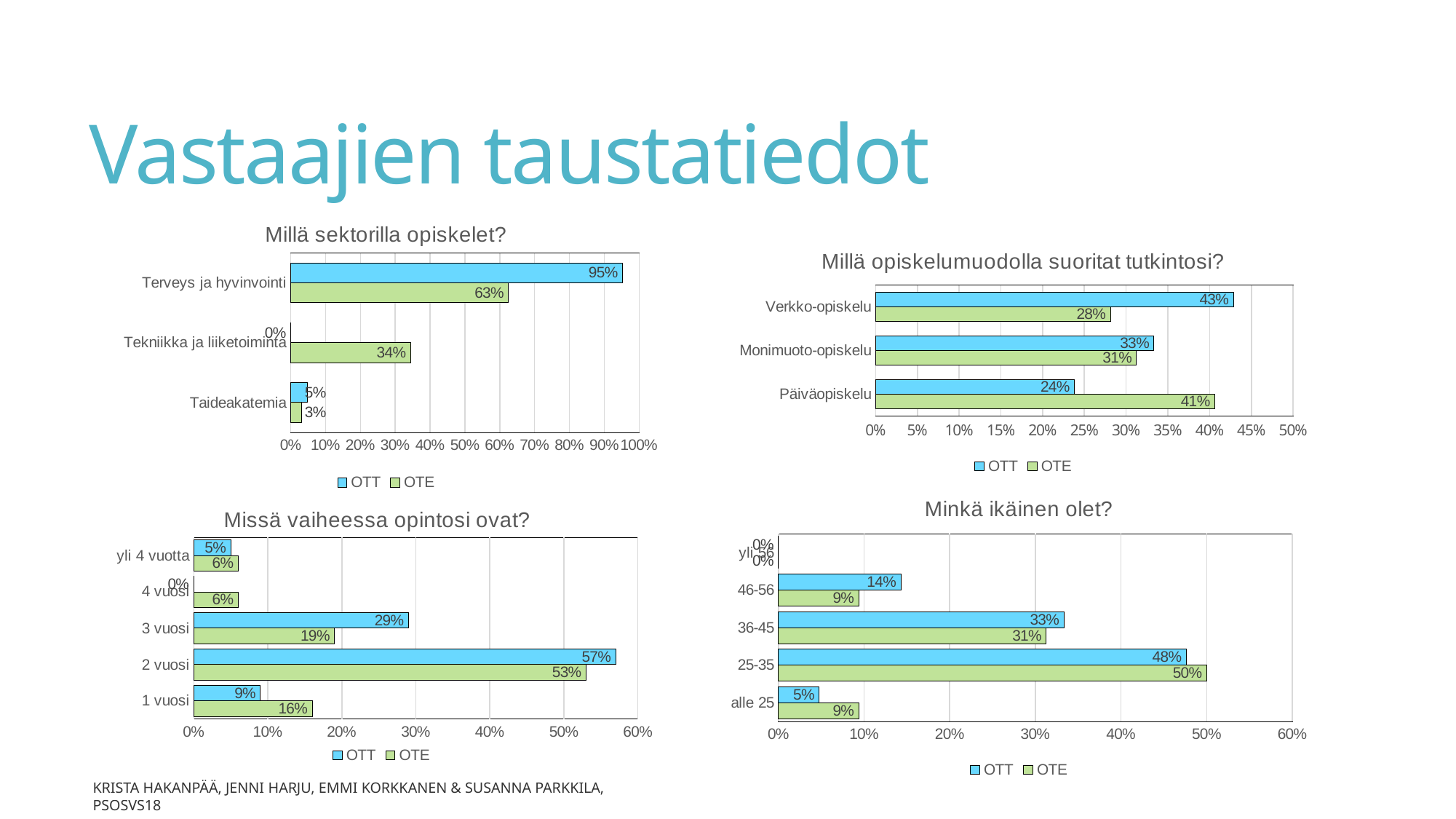
How many series does the legend of the chart 'Minkä ikäinen olet?' list? 2 In the chart 'Millä sektorilla opiskelet?', what is the OTE value for Tekniikka ja liiketoiminta? 34% In the chart 'Missä vaiheessa opintosi ovat?', which category has the lowest OTT value? 4 vuosi In the chart 'Missä vaiheessa opintosi ovat?', what is the OTT value for 2 vuosi? 57% In the chart 'Millä opiskelumuodolla suoritat tutkintosi?', which category has the highest OTT value? Verkko-opiskelu In the chart 'Minkä ikäinen olet?', what is the OTE value for 25-35? 50% In the chart 'Minkä ikäinen olet?', what is the difference between the OTT and OTE values for 46-56? 5% In the chart 'Missä vaiheessa opintosi ovat?', which is larger for 1 vuosi, the OTT value or the OTE value? OTE In the chart 'Millä sektorilla opiskelet?', what is the OTT value for Terveys ja hyvinvointi? 95% In the chart 'Millä opiskelumuodolla suoritat tutkintosi?', how many categories are shown? 3 In the chart 'Millä opiskelumuodolla suoritat tutkintosi?', what is the OTE value for Päiväopiskelu? 41% In the chart 'Millä sektorilla opiskelet?', what is the difference between the OTT and OTE values for Terveys ja hyvinvointi? 32%